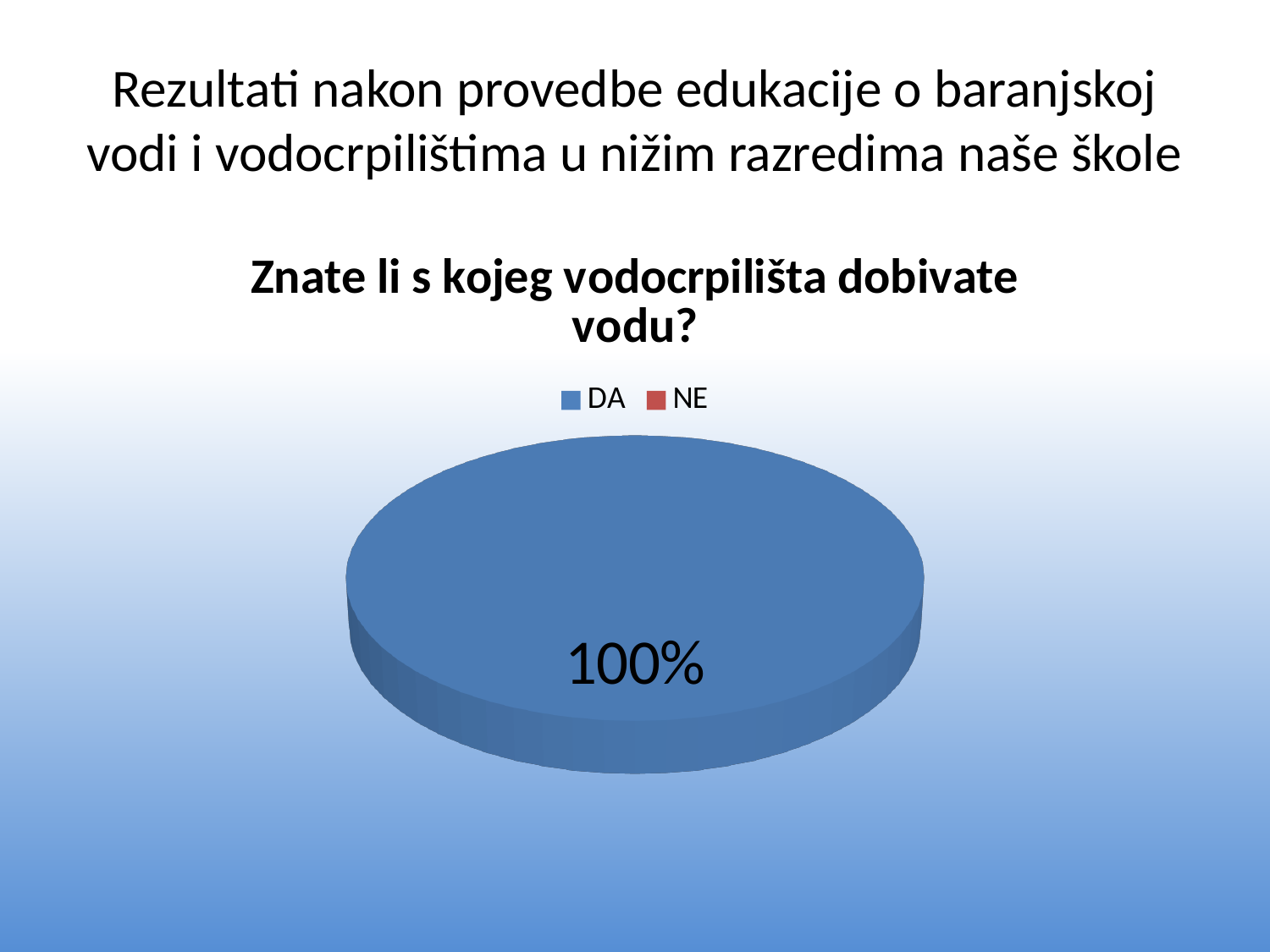
How many entries does the legend list? 2 What is the title of the chart? Znate li s kojeg vodocrpilišta dobivate vodu? What kind of chart is shown on the slide? pie chart What share of the pie does DA account for? 100% What colour represents DA in the chart? blue Which category has the largest share of the pie? DA Which of the two categories, DA or NE, has the larger share? DA Is the share for DA greater or less than 50%? greater What value is printed as the data label on the pie? 100%